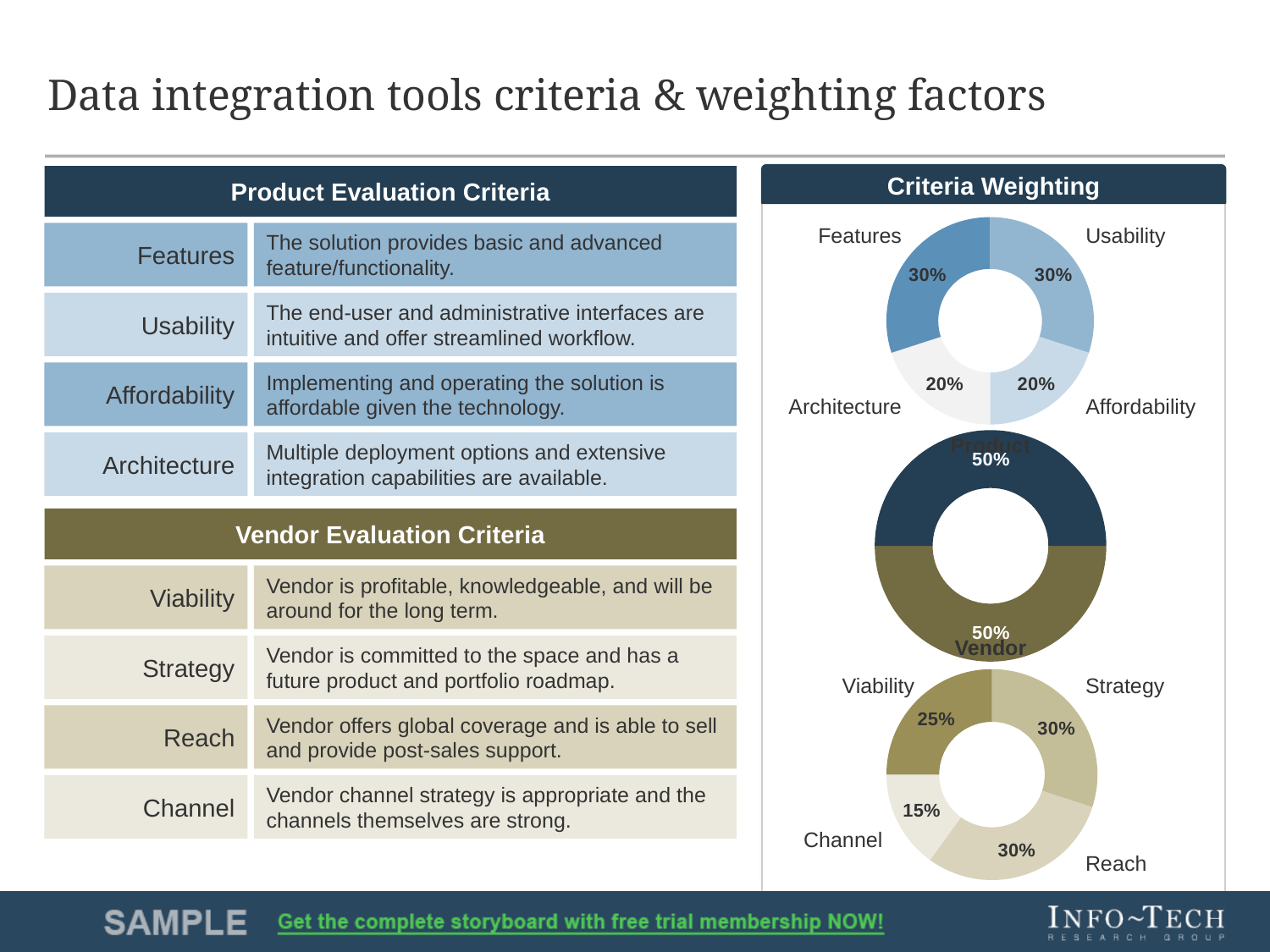
In the bottom donut chart under Criteria Weighting, what is the value for Channel? 15% What kind of chart is used in the Criteria Weighting panel? Donut chart In the top donut chart under Criteria Weighting, what is the value for Features? 30% How many categories does the top donut chart under Criteria Weighting show? 4 In the top donut chart under Criteria Weighting, which is larger, Usability or Architecture? Usability In the top donut chart under Criteria Weighting, what is the value for Affordability? 20% How many categories does the middle donut chart under Criteria Weighting show? 2 In the top donut chart under Criteria Weighting, what is the difference between Features and Architecture? 10% In the bottom donut chart under Criteria Weighting, which category has the lowest value? Channel In the bottom donut chart under Criteria Weighting, what is the value for Viability? 25% In the bottom donut chart under Criteria Weighting, what is the difference between Strategy and Channel? 15% In the middle donut chart under Criteria Weighting, what is the value for Vendor? 50%